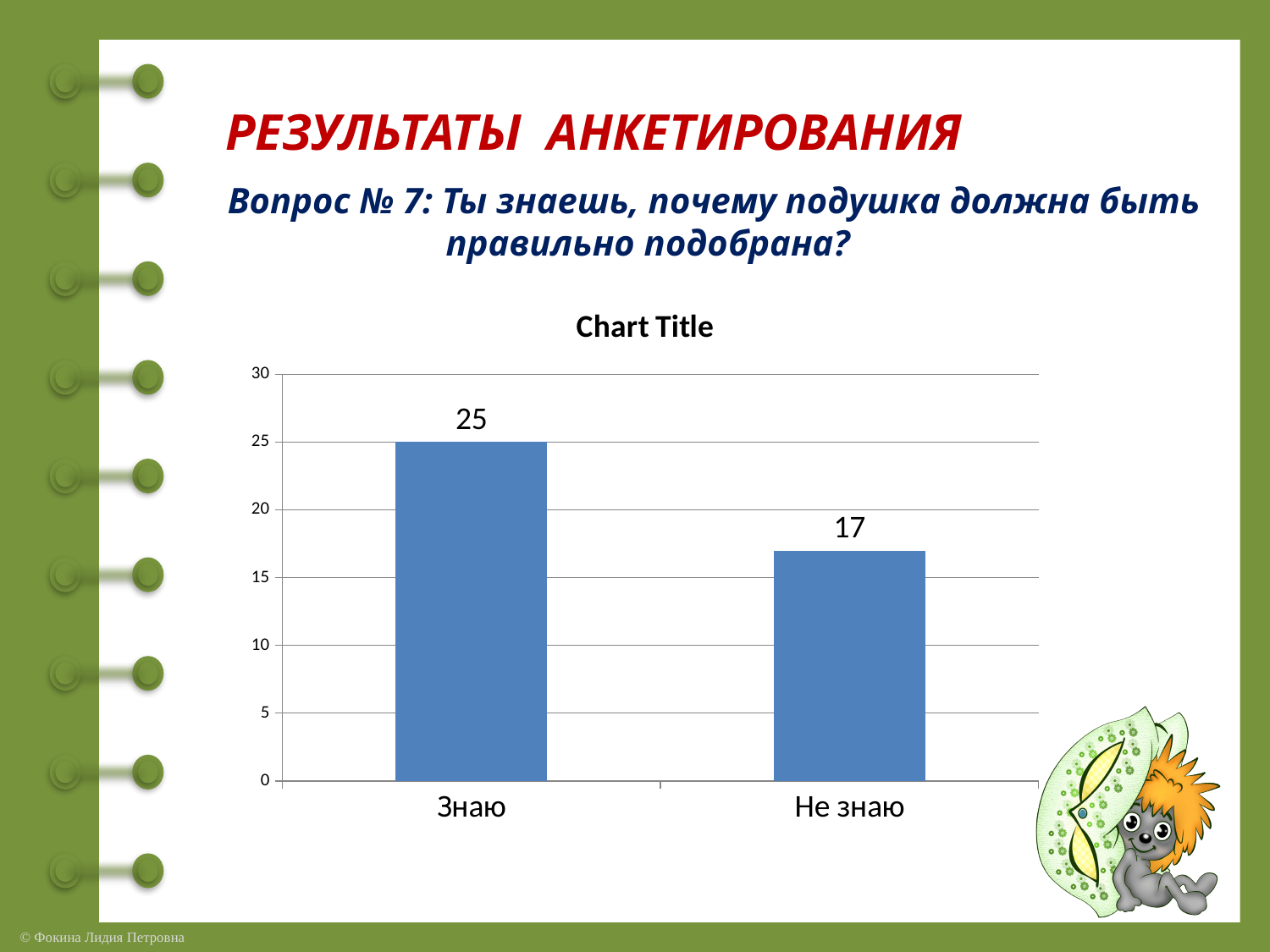
What is the value for "Не знаю"? 17 What is the value for "Знаю"? 25 What kind of chart is shown on the slide? bar chart How many categories are shown on the chart? 2 Which category has the highest value? Знаю What is the difference between the values for "Знаю" and "Не знаю"? 8 Which category has the lowest value? Не знаю What is the title shown above the chart? Chart Title Is the value for "Знаю" greater or less than 20? greater Is the value for "Не знаю" greater or less than 20? less What is the highest value shown on the vertical axis? 30 Which is larger, the value for "Знаю" or the value for "Не знаю"? Знаю